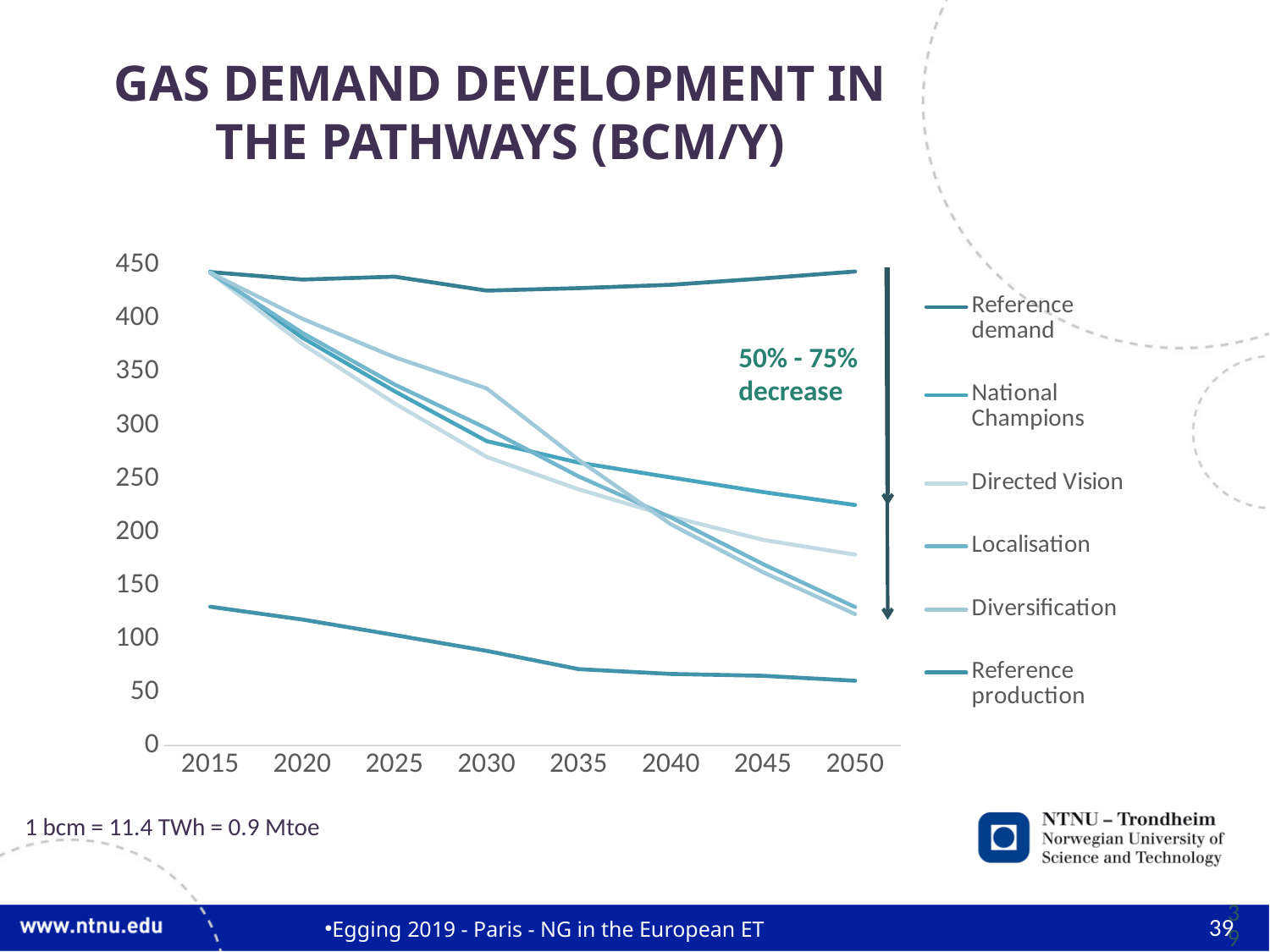
In 2015, which is larger: Reference demand or Reference production? Reference demand Does the Reference production series rise or fall from 2015 to 2050? fall Is the value for Reference production in 2050 greater or less than 100? less Is the value for Reference production in 2015 greater or less than 150? less Is the value for National Champions in 2050 greater or less than 200? greater Which series has the lowest value in 2050? Reference production How many years are marked on the x axis? 8 What decrease range is annotated next to the arrow on the chart? 50% - 75% decrease What kind of chart is shown on the slide? line chart Which series has the highest value in 2050? Reference demand How many series does the legend list? 6